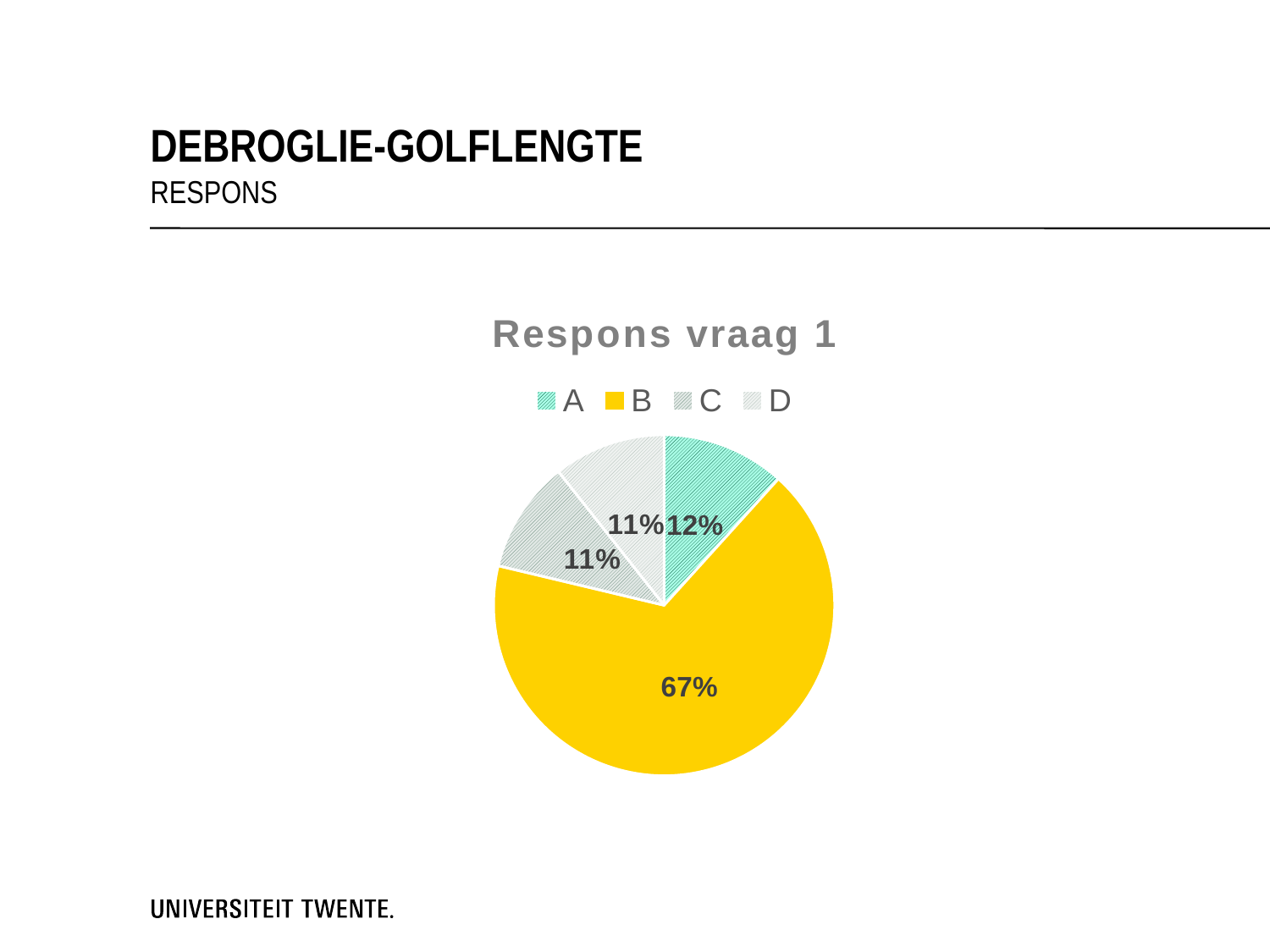
What is the combined share of categories A, C and D? 34% How many entries does the legend list? 4 What kind of chart is shown on the slide? Pie chart Which is larger, the share for A or the share for C? A What percentage is shown for category A? 12% What percentage is shown for category C? 11% What is the difference in percentage points between category B and category A? 55% What is the title of the chart? Respons vraag 1 Which category has the largest share of the pie? B How many categories are shown in the pie chart? 4 What percentage of the pie does category B represent? 67% What percentage is shown for category D? 11%